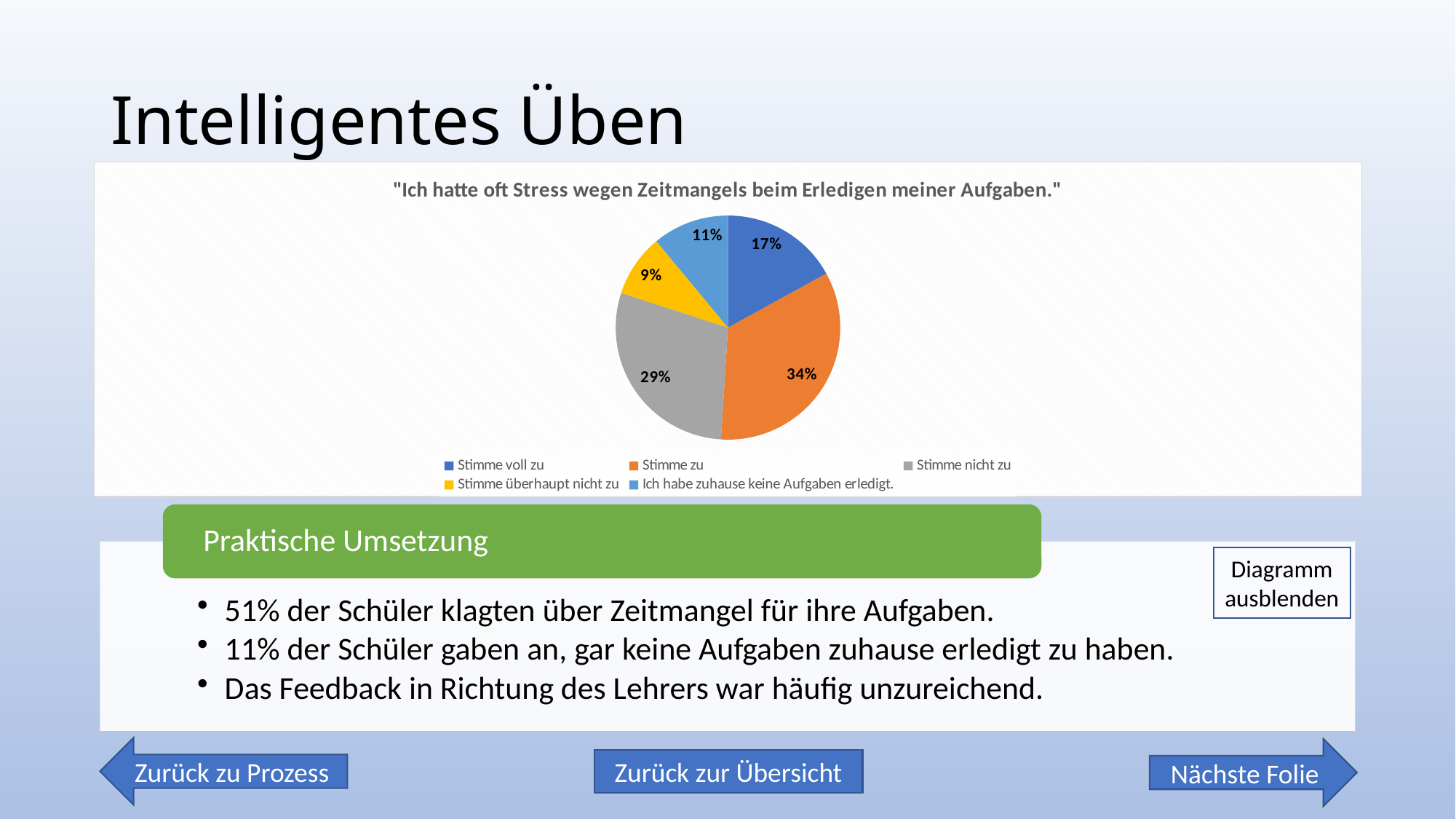
How many slices does the pie chart have? 5 What percentage of the pie is labelled "Ich habe zuhause keine Aufgaben erledigt."? 11% What percentage of the pie is labelled "Stimme überhaupt nicht zu"? 9% What percentage of the pie is labelled "Stimme voll zu"? 17% Which category has the smallest share of the pie? Stimme überhaupt nicht zu What kind of chart is shown on the slide? Pie chart What is the difference in percentage points between "Stimme zu" and "Stimme nicht zu"? 5 What percentage of the pie is labelled "Stimme nicht zu"? 29% What percentage of the pie is labelled "Stimme zu"? 34% Which category has the largest share of the pie? Stimme zu Which is larger, the share for "Stimme voll zu" or the share for "Ich habe zuhause keine Aufgaben erledigt."? Stimme voll zu What is the title of the pie chart? "Ich hatte oft Stress wegen Zeitmangels beim Erledigen meiner Aufgaben."